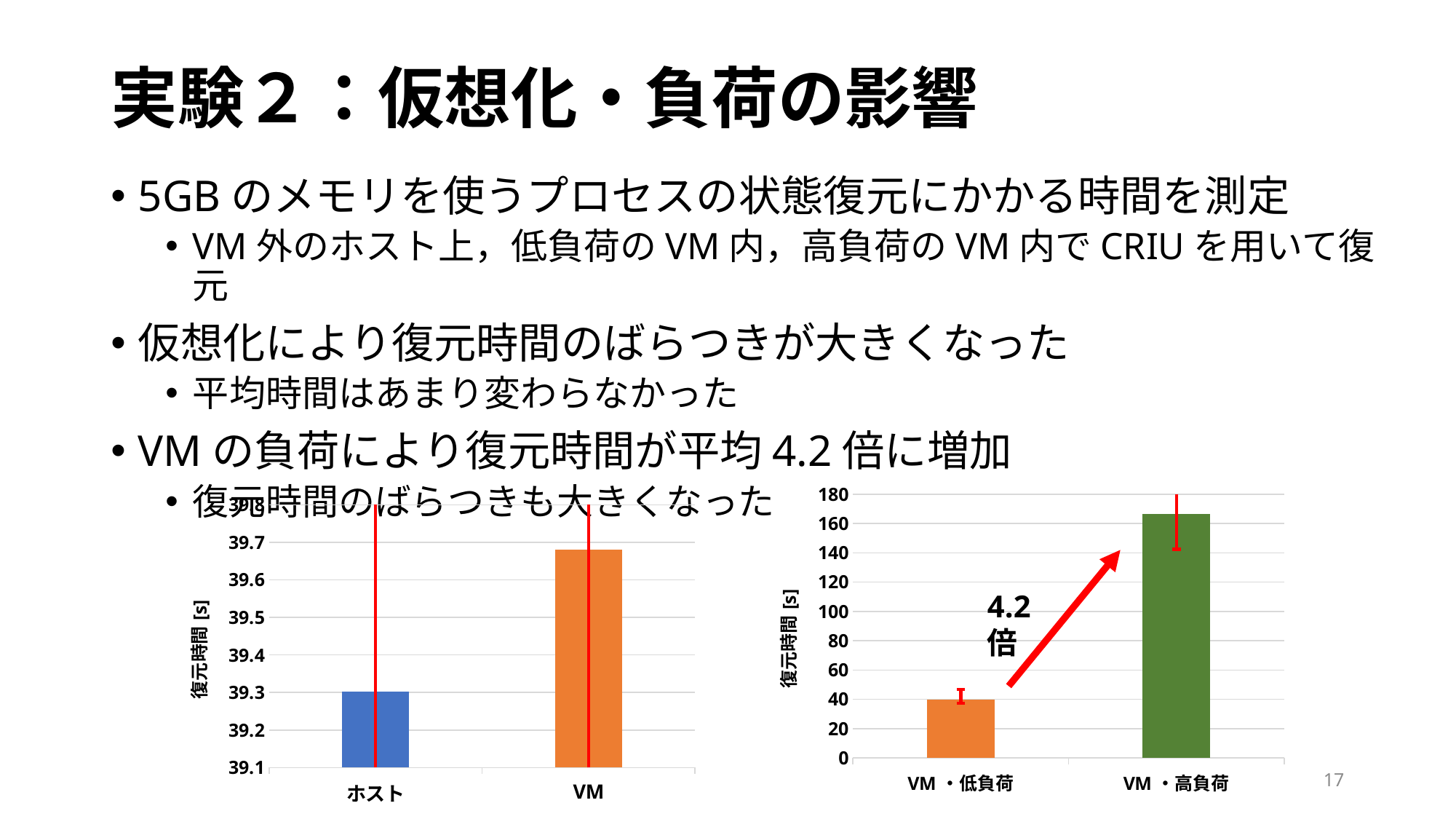
In the right chart (VM・低負荷 vs VM・高負荷), what is the y-axis label? 復元時間 [s] In the right chart (VM・低負荷 vs VM・高負荷), what factor is written next to the red arrow? 4.2倍 In the left chart (ホスト vs VM), is the value for ホスト greater or less than 39.4? less In the right chart (VM・低負荷 vs VM・高負荷), which category has the lowest bar? VM・低負荷 In the left chart (ホスト vs VM), which category has the higher bar? VM In the right chart (VM・低負荷 vs VM・高負荷), which category has the highest bar? VM・高負荷 In the left chart (ホスト vs VM), how many categories are shown on the x axis? 2 In the right chart (VM・低負荷 vs VM・高負荷), is the value for VM・低負荷 greater or less than 60? less In the left chart (ホスト vs VM), is the value for VM greater or less than 39.6? greater What kind of chart is the left chart (ホスト vs VM)? bar chart In the left chart (ホスト vs VM), which category has the lower bar? ホスト